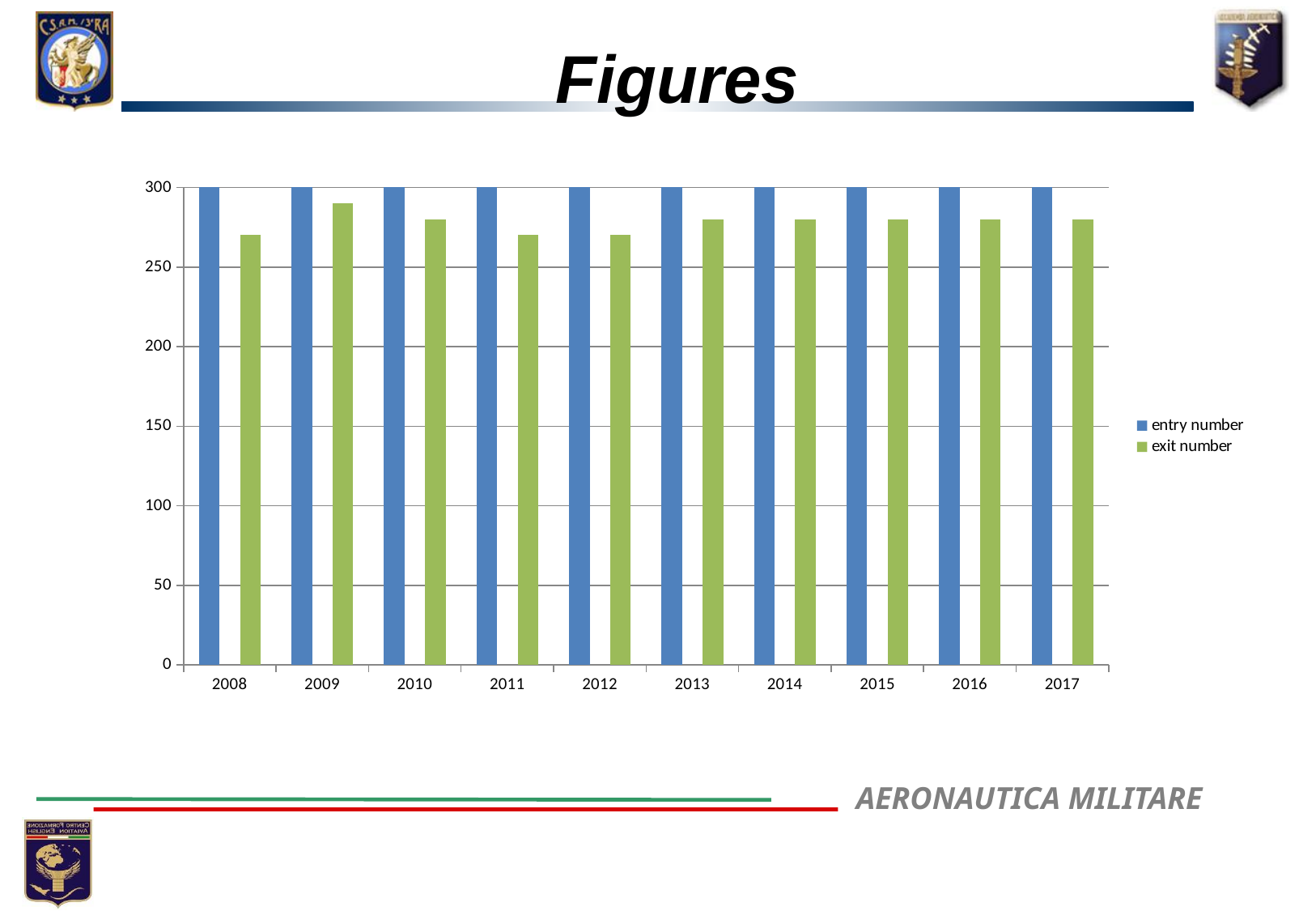
What kind of chart is shown on the slide? bar chart What is the entry number for 2008? 300 In which year is the exit number highest? 2009 How many series does the legend list? 2 In 2010, which is larger, the entry number or the exit number? entry number Does the entry number rise, fall or stay flat from 2008 to 2017? stays flat Is the exit number for 2009 greater or less than 300? less How many years are shown on the x axis? 10 Is the exit number for 2008 greater or less than 250? greater What is the entry number for 2017? 300 What colour are the entry number bars? blue Is the exit number for 2017 greater or less than 250? greater